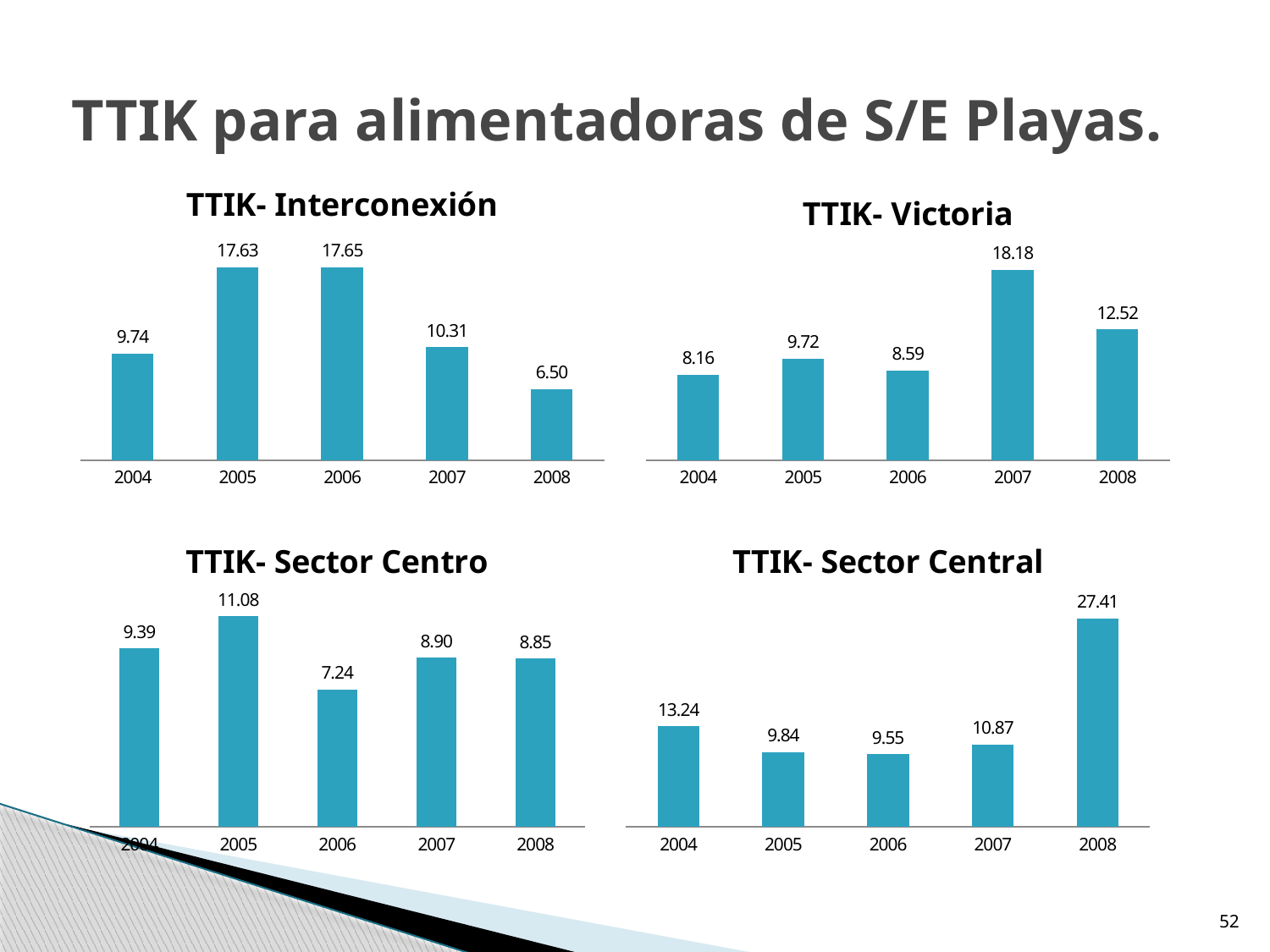
In the TTIK- Victoria chart, which year has the highest value? 2007 In the TTIK- Interconexión chart, what is the value for 2005? 17.63 How many years are shown on the x axis of the TTIK- Sector Central chart? 5 In the TTIK- Sector Centro chart, which year has the highest value? 2005 In the TTIK- Interconexión chart, what is the difference between the values for 2007 and 2008? 3.81 In the TTIK- Sector Centro chart, what is the value for 2006? 7.24 In the TTIK- Victoria chart, which year has the lowest value? 2004 What kind of chart is the TTIK- Victoria chart? Bar chart In the TTIK- Sector Central chart, which is larger, the value for 2004 or the value for 2007? 2004 In the TTIK- Victoria chart, what is the value for 2008? 12.52 In the TTIK- Interconexión chart, which year has the lowest value? 2008 In the TTIK- Sector Central chart, what is the value for 2008? 27.41